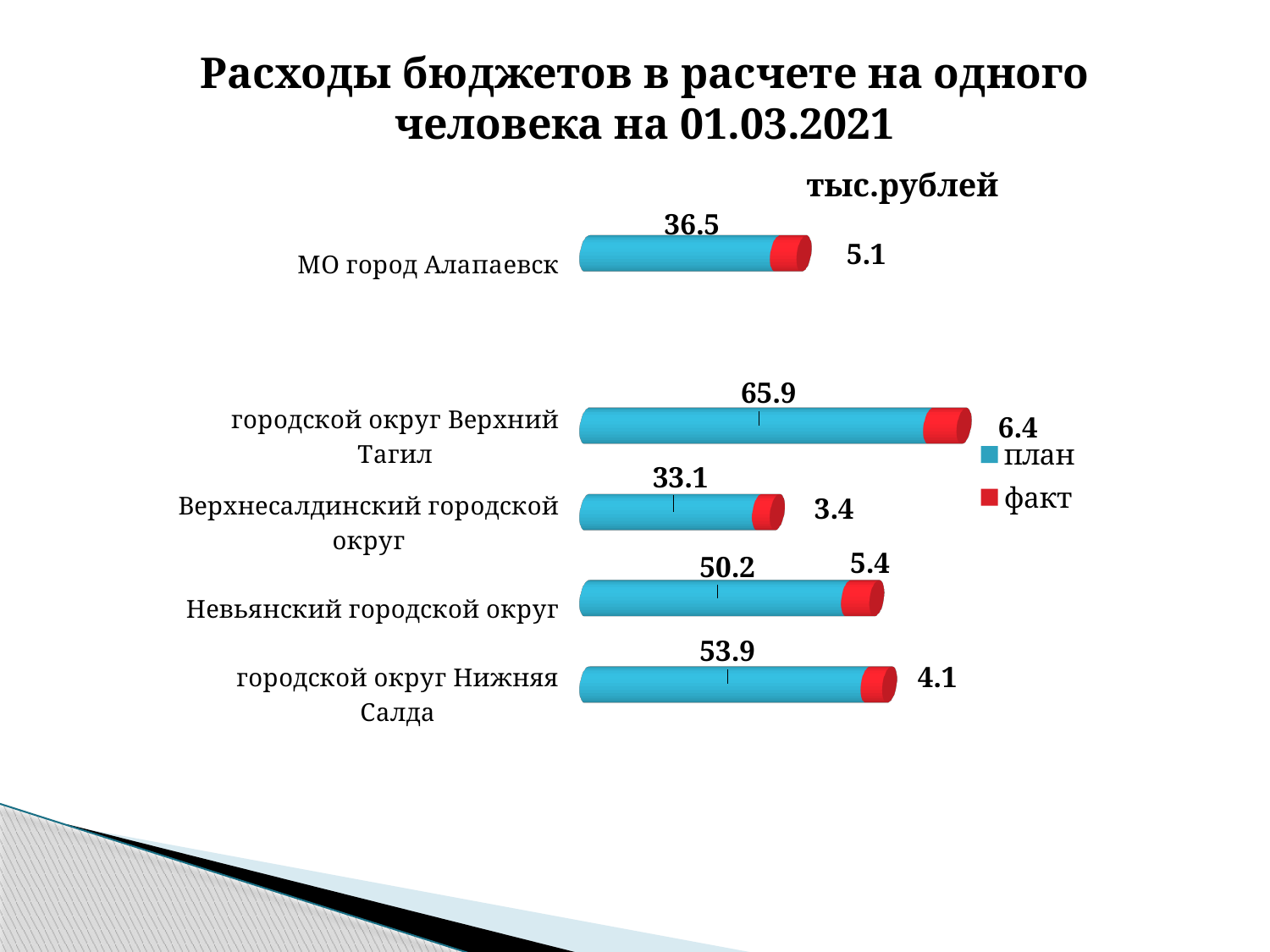
How many series does the legend list? 2 Which category has the highest план value? городской округ Верхний Тагил What unit is indicated above the chart? тыс.рублей What kind of chart is shown on the slide? bar chart What is the план value for МО город Алапаевск? 36.5 Which category has the lowest факт value? Верхнесалдинский городской округ What is the total of the stacked bar for Верхнесалдинский городской округ? 36.5 What is the difference between the план values for городской округ Нижняя Салда and Невьянский городской округ? 3.7 Which is larger: the факт value for МО город Алапаевск or the факт value for городской округ Нижняя Салда? МО город Алапаевск What is the план value for городской округ Верхний Тагил? 65.9 How many categories are shown in the chart? 5 What is the факт value for Невьянский городской округ? 5.4